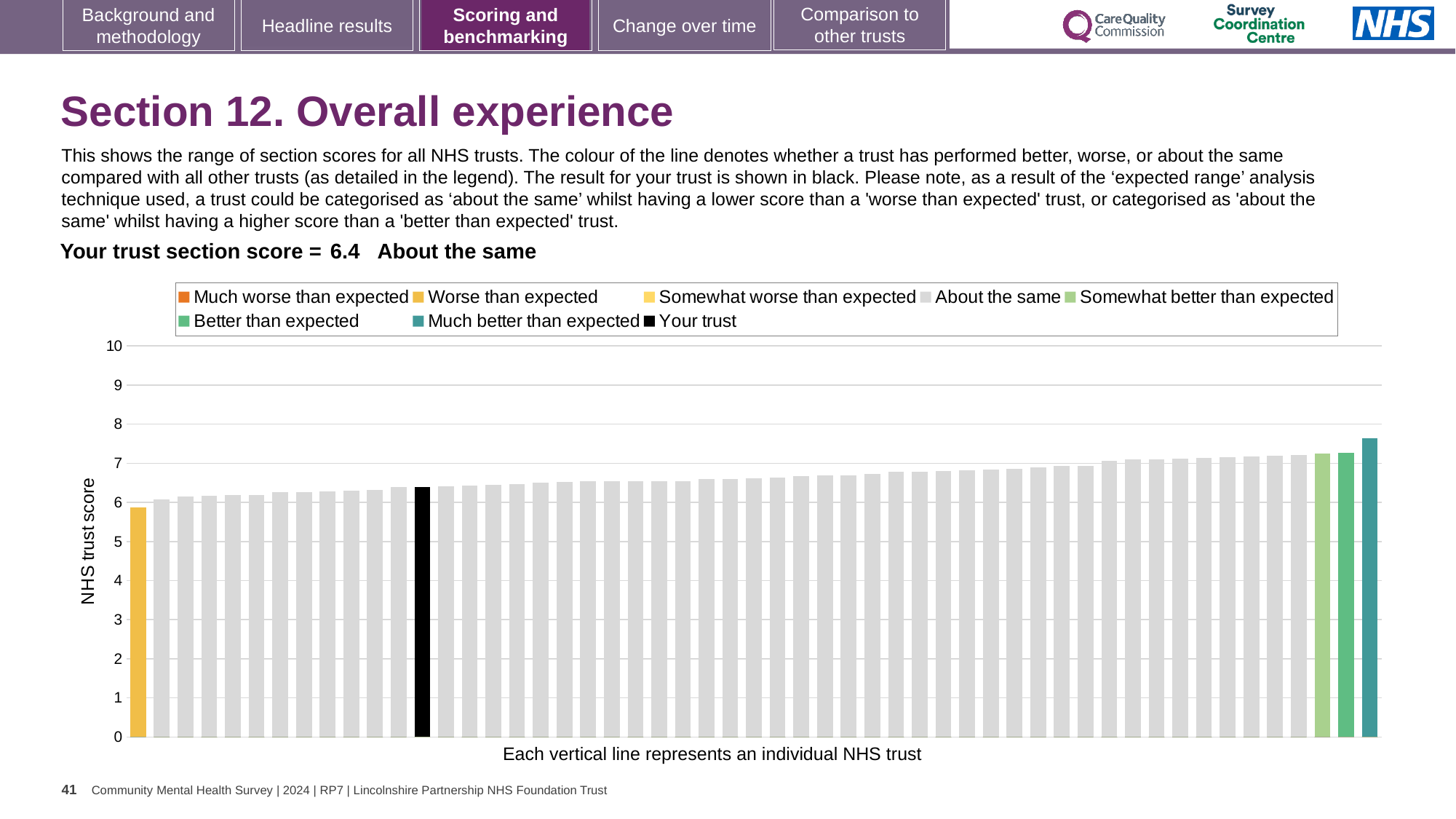
Is the value for the tallest bar (Much better than expected) greater or less than 7? greater Which is higher, the 'Your trust' bar or the 'Worse than expected' bar? Your trust Is the value for the 'Your trust' bar greater or less than 7? less How many entries does the chart legend list? 8 What colour is used for the 'Your trust' bar in the chart? black Do the bar values rise or fall from left to right along the x axis? rise What kind of chart is shown on the slide? bar chart How many bars in the chart are coloured something other than grey? 5 Is the value for the yellow 'Worse than expected' bar greater or less than 5? greater Which benchmarking category is your trust placed in for Section 12? About the same What is the section score for your trust shown on the slide? 6.4 What is the label on the vertical axis of the chart? NHS trust score